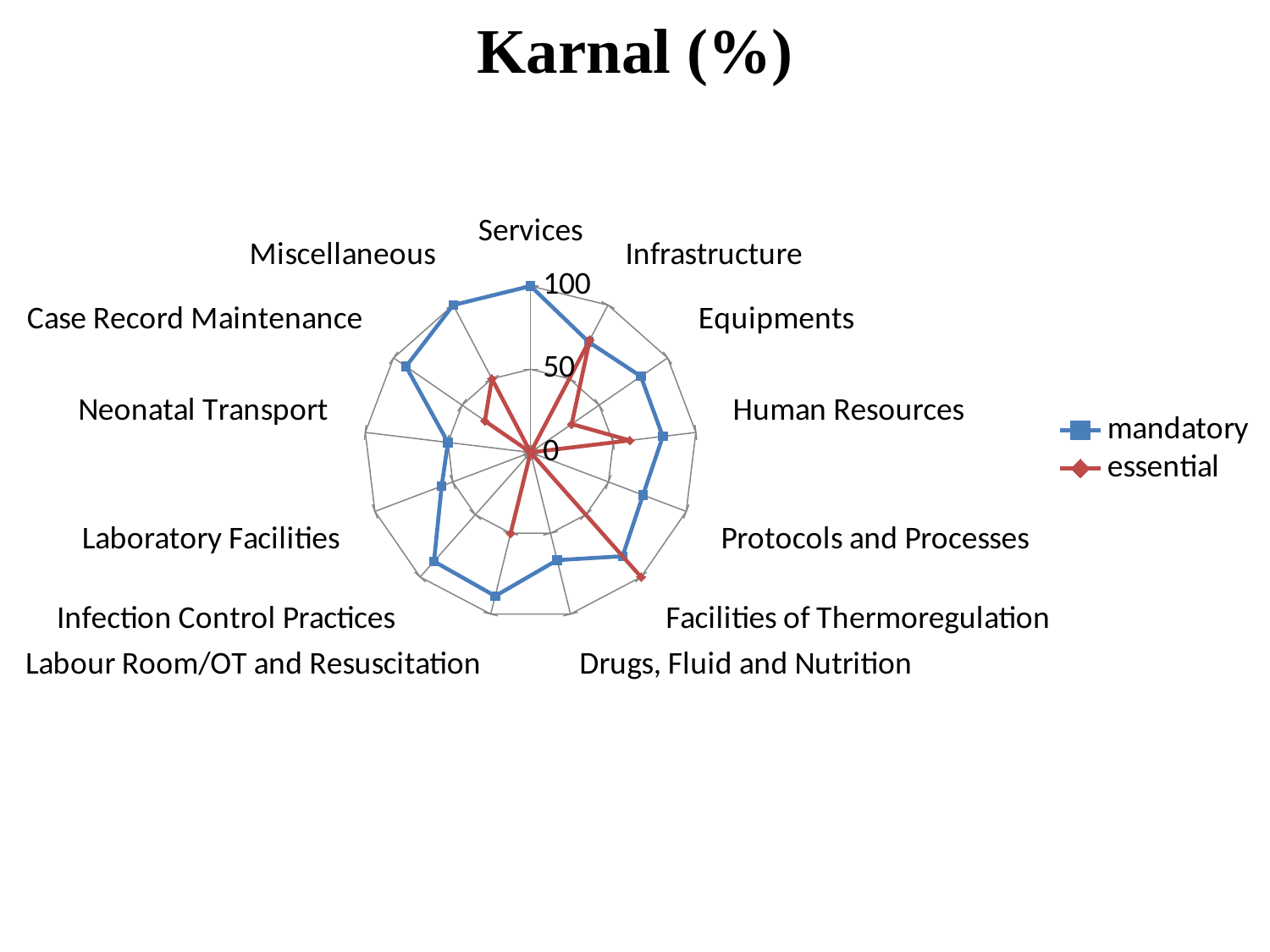
Which colour represents the essential series? red Is the essential value for Services greater or less than 50? less Is the essential value for Facilities of Thermoregulation greater or less than 50? greater What kind of chart is shown on the slide? radar chart How many categories are plotted around the radar chart? 13 Is the mandatory value for Human Resources greater or less than 50? greater For Services, which series has the larger value, mandatory or essential? mandatory What is the mandatory value for Services? 100 What is the title of the chart? Karnal (%) How many series does the legend list? 2